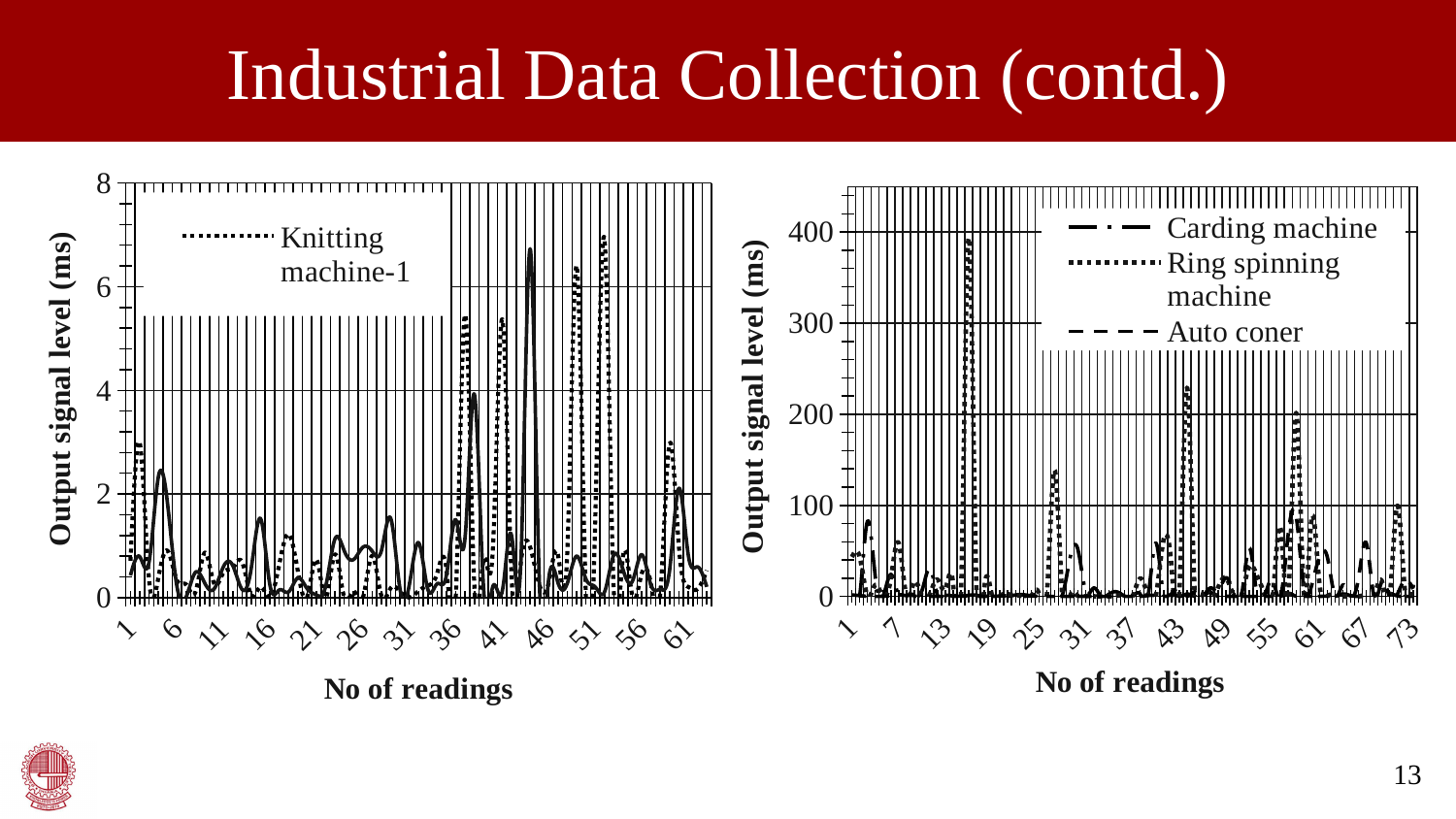
What kind of chart is the left chart on the slide? line chart On the right chart, which series reaches the highest output signal level? Ring spinning machine On the right chart, is the highest peak of the Ring spinning machine series greater or less than 300? greater On the left chart, is the highest value reached by any line greater or less than 4? greater How many series does the legend of the right chart list? 3 What series is named in the legend of the left chart? Knitting machine-1 What is the y-axis title of the right chart? Output signal level (ms) On the left chart, is the highest peak of the Knitting machine-1 series greater or less than 6? greater